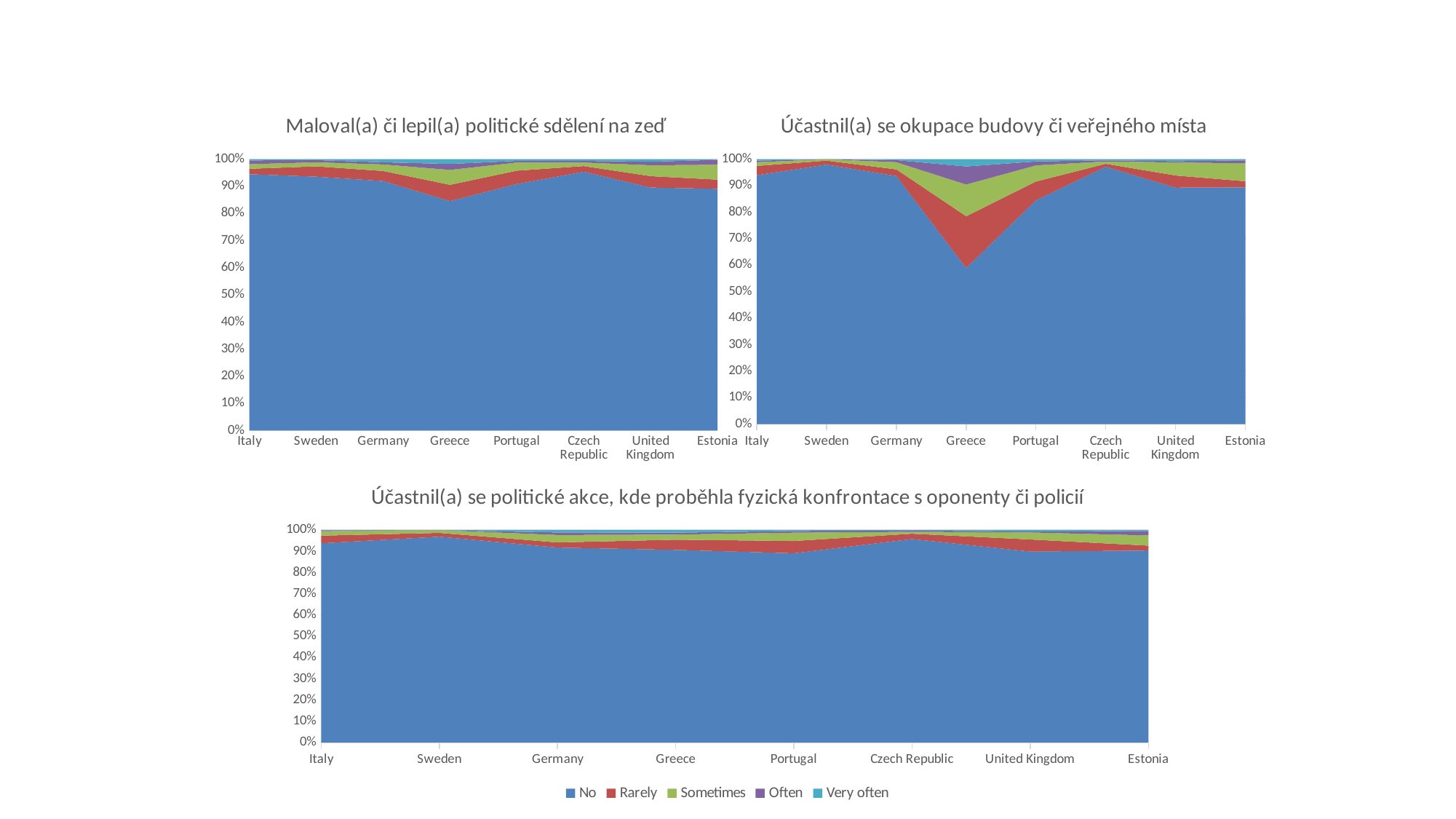
In the chart titled "Maloval(a) či lepil(a) politické sdělení na zeď", is the "No" share for Greece greater or less than 90%? less In the chart titled "Účastnil(a) se okupace budovy či veřejného místa", which country has a larger "No" share, Sweden or Greece? Sweden In the bottom chart, is the "No" share for Czech Republic greater or less than 90%? greater Which series is shown in blue in the legend? No In the chart titled "Maloval(a) či lepil(a) politické sdělení na zeď", is the "No" share for Italy greater or less than 90%? greater In the chart titled "Účastnil(a) se okupace budovy či veřejného místa", which country has the lowest share of "No"? Greece In the chart titled "Maloval(a) či lepil(a) politické sdělení na zeď", which country has the lowest share of "No"? Greece How many countries are shown on the x axis of the chart titled "Účastnil(a) se okupace budovy či veřejného místa"? 8 How many series does the legend at the bottom of the slide list? 5 What kind of chart is the chart titled "Maloval(a) či lepil(a) politické sdělení na zeď"? Stacked area chart What is the title of the bottom chart on the slide? Účastnil(a) se politické akce, kde proběhla fyzická konfrontace s oponenty či policií